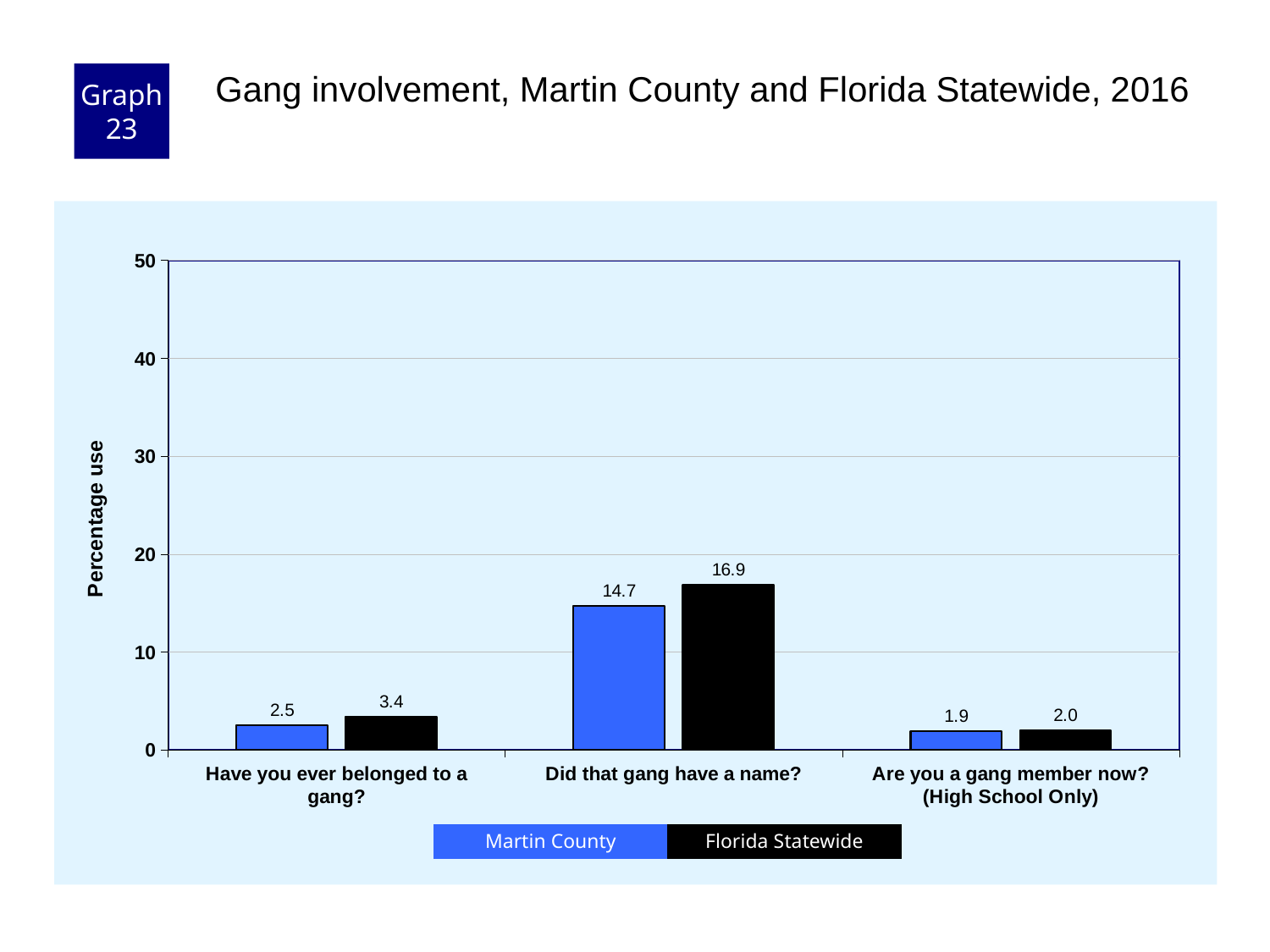
How many question categories are shown on the x axis? 3 What is the label of the y axis? Percentage use For "Have you ever belonged to a gang?", which is larger: Martin County or Florida Statewide? Florida Statewide Is the Florida Statewide value for "Did that gang have a name?" greater or less than 20? less What is the Martin County value for "Are you a gang member now? (High School Only)"? 1.9 How many series does the legend list? 2 What kind of chart is shown on the slide? bar chart Which question has the highest Florida Statewide value? Did that gang have a name? What is the Martin County value for "Did that gang have a name?"? 14.7 What is the difference between the Florida Statewide and Martin County values for "Did that gang have a name?"? 2.2 Which question has the lowest Martin County value? Are you a gang member now? (High School Only) What is the Florida Statewide value for "Have you ever belonged to a gang?"? 3.4